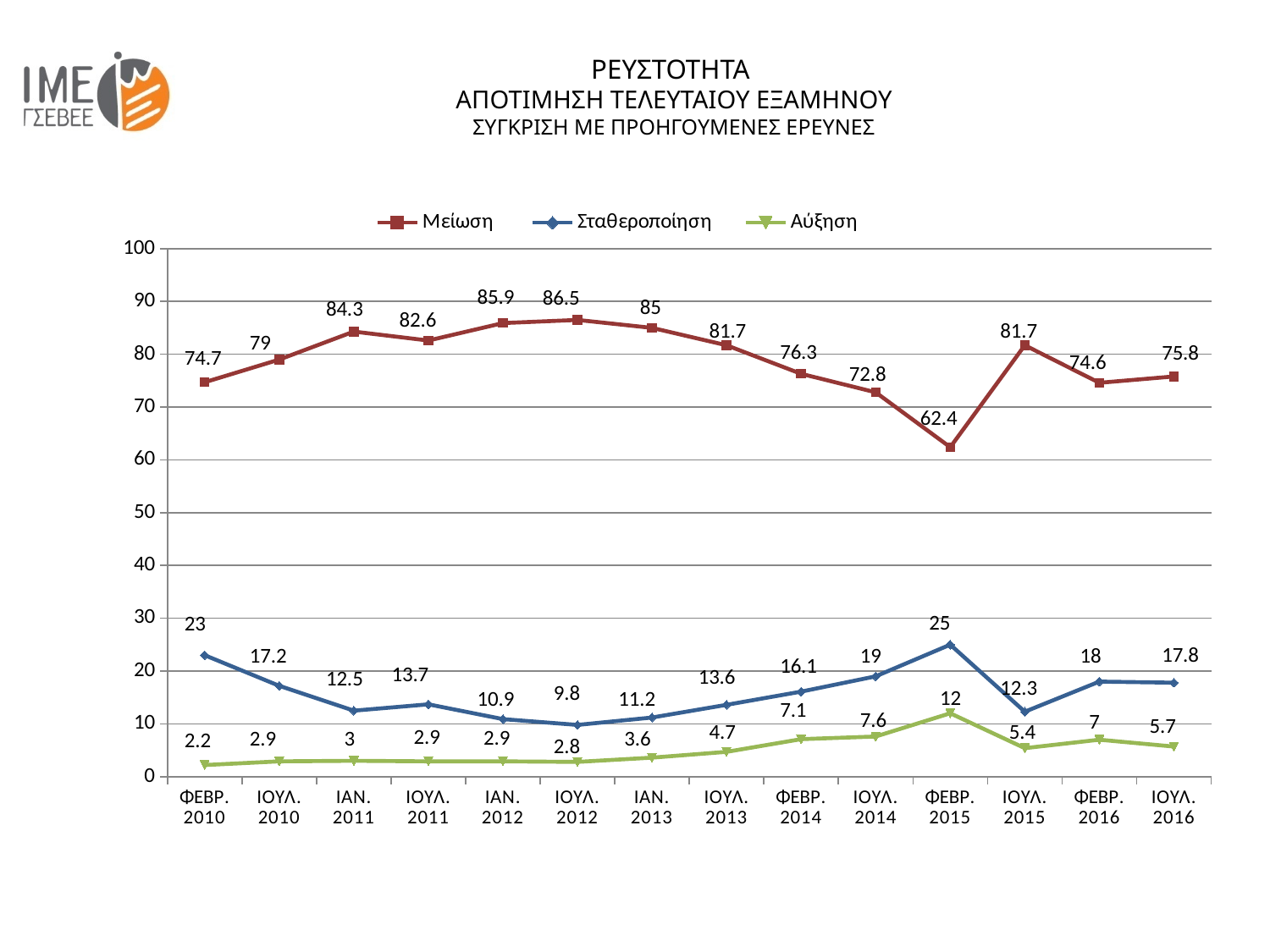
How many series does the legend list? 3 How many time periods are shown on the x axis? 14 In which period is Μείωση at its lowest? ΦΕΒΡ. 2015 What is the value of Αύξηση for ΙΟΥΛ. 2016? 5.7 Which is larger: Σταθεροποίηση in ΦΕΒΡ. 2010 or in ΙΟΥΛ. 2010? ΦΕΒΡ. 2010 Which series is drawn in green? Αύξηση What kind of chart is shown? line chart What is the value of Σταθεροποίηση for ΦΕΒΡ. 2015? 25 What is the difference between Μείωση in ΙΟΥΛ. 2015 and ΦΕΒΡ. 2015? 19.3 Does Μείωση rise or fall from ΙΟΥΛ. 2012 to ΦΕΒΡ. 2015? fall In which period is Αύξηση at its highest? ΦΕΒΡ. 2015 What is the value of Μείωση for ΙΟΥΛ. 2012? 86.5